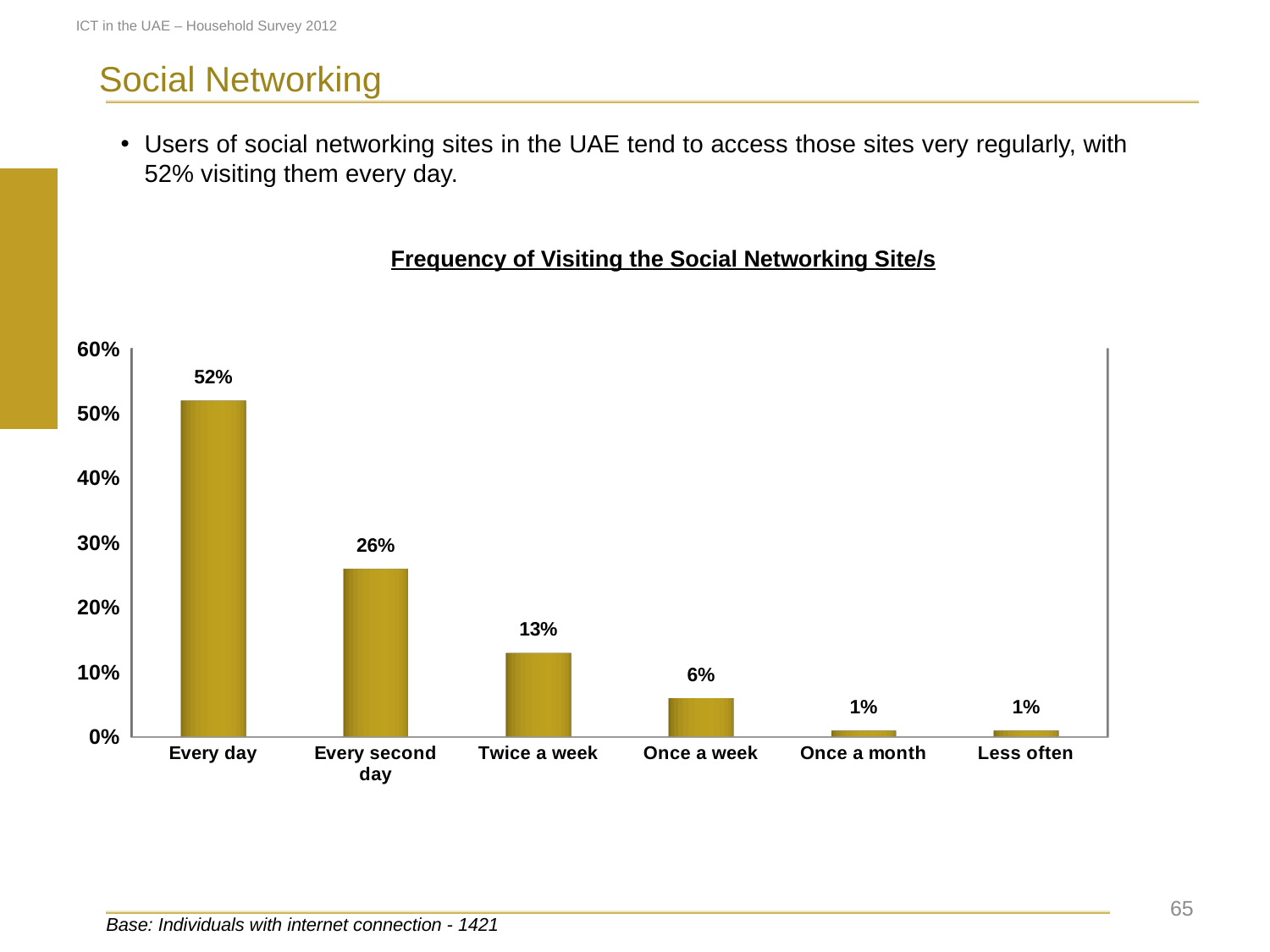
What percentage of users visit social networking sites twice a week? 13% What kind of chart is shown on the slide? Bar chart What percentage of users visit social networking sites every day? 52% What is the title of the chart? Frequency of Visiting the Social Networking Site/s What is the value for 'Once a week'? 6% What is the difference between the 'Twice a week' and 'Once a week' values? 7% What is the difference between the 'Every day' and 'Every second day' values? 26% Which frequency category has the highest value? Every day What is the value for 'Every second day'? 26% Do the values rise or fall moving from left to right along the x axis? Fall How many frequency categories are shown on the x axis? 6 Which is larger, the value for 'Every second day' or the value for 'Twice a week'? Every second day